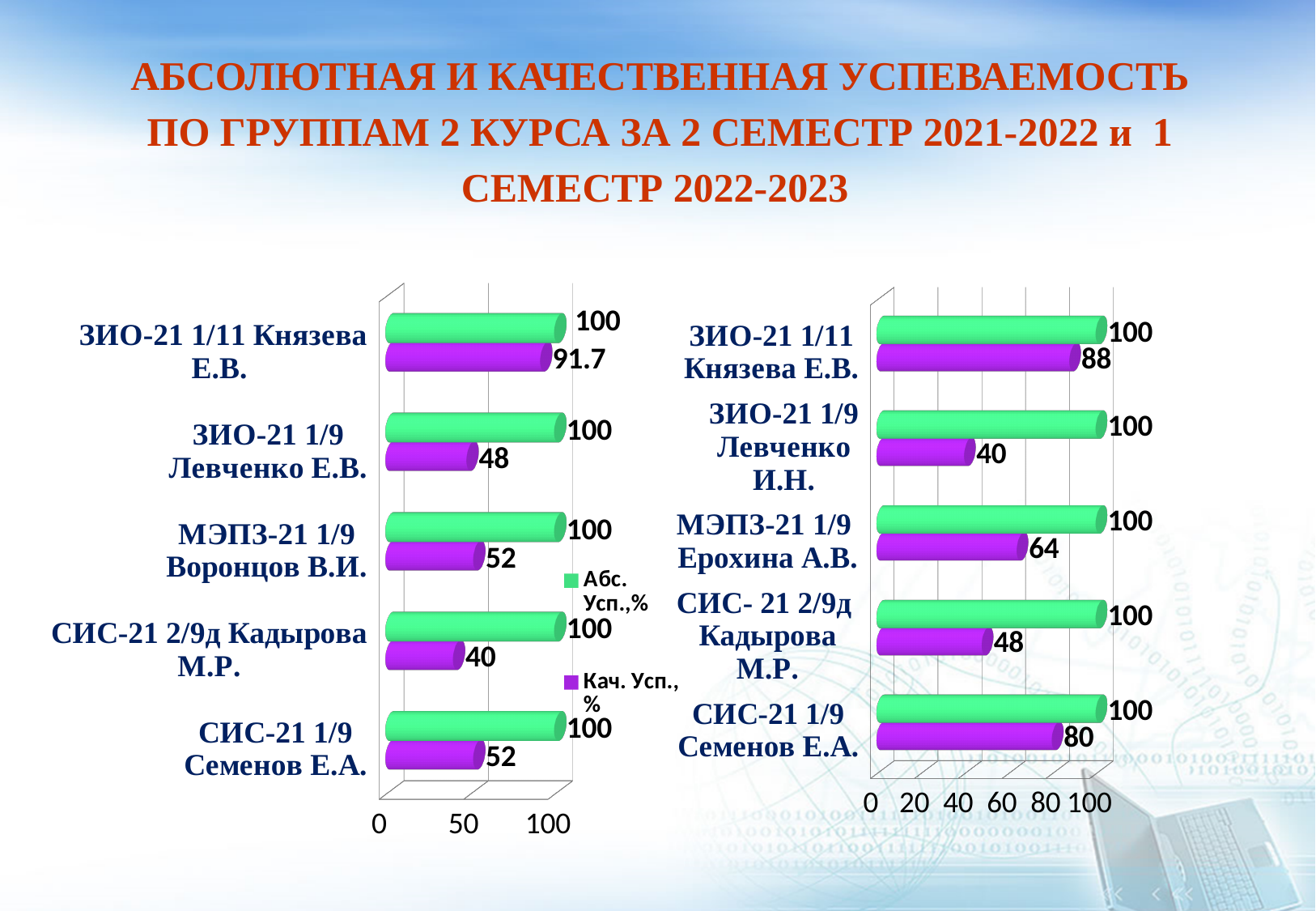
In the left chart, which group has the highest Кач. Усп.,% value? ЗИО-21 1/11 Князева Е.В. In the right chart, what is the difference between the purple bar values for ЗИО-21 1/11 Князева Е.В. and СИС-21 2/9д Кадырова М.Р.? 40 In the left chart, what is the Кач. Усп.,% value for ЗИО-21 1/11 Князева Е.В.? 91.7 In the right chart, which group has the lowest purple bar value? ЗИО-21 1/9 Левченко И.Н. How many groups are shown in the left chart? 5 How many series does the legend of the left chart list? 2 In the left chart, what is the Кач. Усп.,% value for СИС-21 2/9д Кадырова М.Р.? 40 In the left chart, what is the difference between the Абс. Усп.,% and Кач. Усп.,% values for ЗИО-21 1/9 Левченко Е.В.? 52 In the right chart, what is the purple bar value for МЭПЗ-21 1/9 Ерохина А.В.? 64 In the right chart, what is the purple bar value for СИС-21 1/9 Семенов Е.А.? 80 In the right chart, which has a larger purple bar value: МЭПЗ-21 1/9 Ерохина А.В. or СИС-21 1/9 Семенов Е.А.? СИС-21 1/9 Семенов Е.А. What type of chart is the right chart? Bar chart